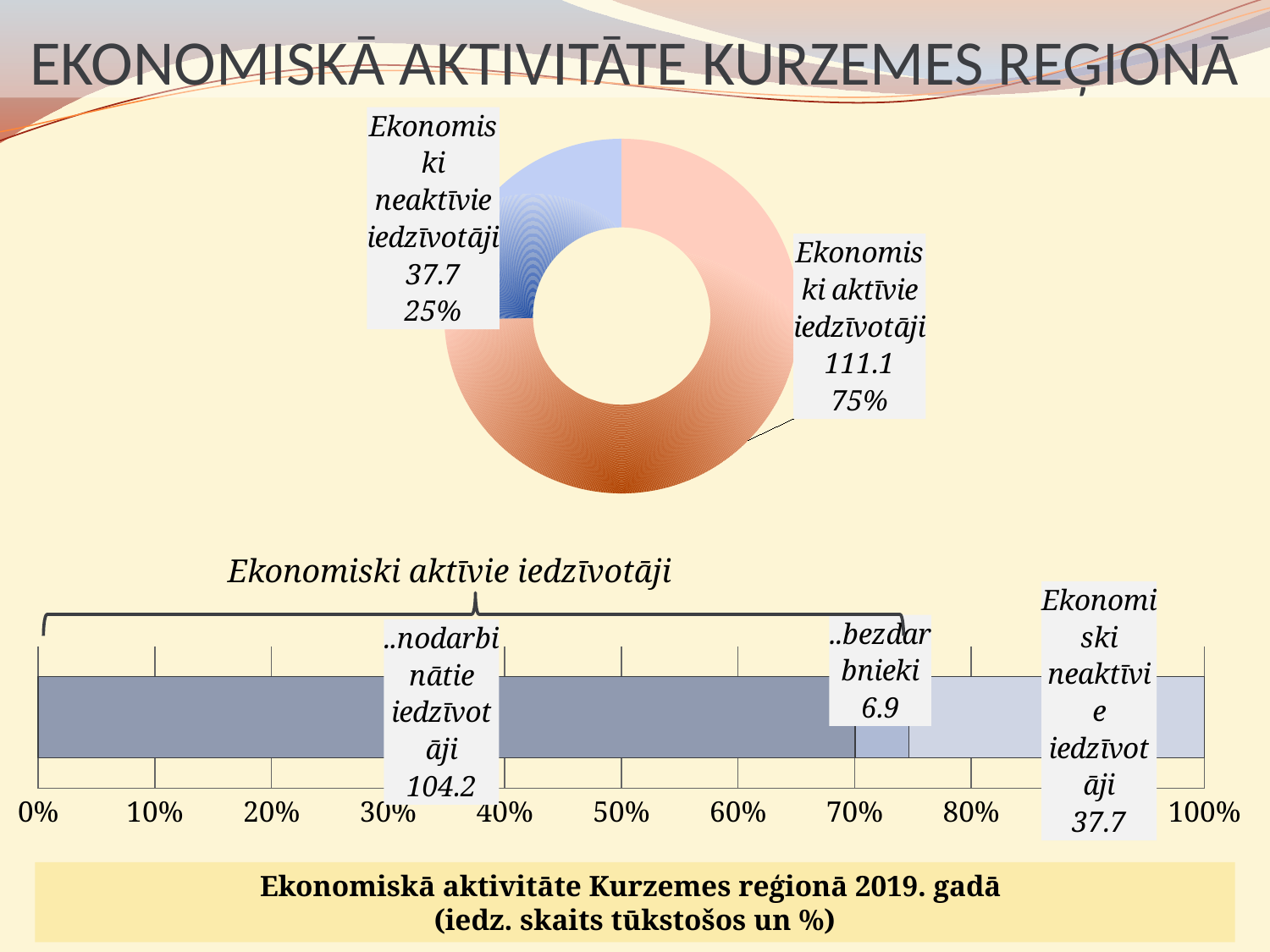
How many slices does the doughnut chart at the top of the slide have? 2 In the doughnut chart at the top of the slide, what percentage share is shown for Ekonomiski neaktīvie iedzīvotāji? 25% In the bar chart at the bottom of the slide, what value is shown for nodarbinātie iedzīvotāji? 104.2 What kind of chart is shown at the bottom of the slide? Bar chart What kind of chart is shown at the top of the slide? Doughnut chart In the bar chart at the bottom of the slide, which segment has the smallest value? bezdarbnieki In the doughnut chart at the top of the slide, which category has the larger value? Ekonomiski aktīvie iedzīvotāji In the bar chart at the bottom of the slide, what value is shown for bezdarbnieki? 6.9 In the bar chart at the bottom of the slide, what is the total of the three segments (nodarbinātie iedzīvotāji, bezdarbnieki and Ekonomiski neaktīvie iedzīvotāji)? 148.8 In the doughnut chart at the top of the slide, what percentage share is shown for Ekonomiski aktīvie iedzīvotāji? 75% In the doughnut chart at the top of the slide, what value is shown for Ekonomiski aktīvie iedzīvotāji? 111.1 In the doughnut chart at the top of the slide, what is the difference between the values for Ekonomiski aktīvie iedzīvotāji and Ekonomiski neaktīvie iedzīvotāji? 73.4